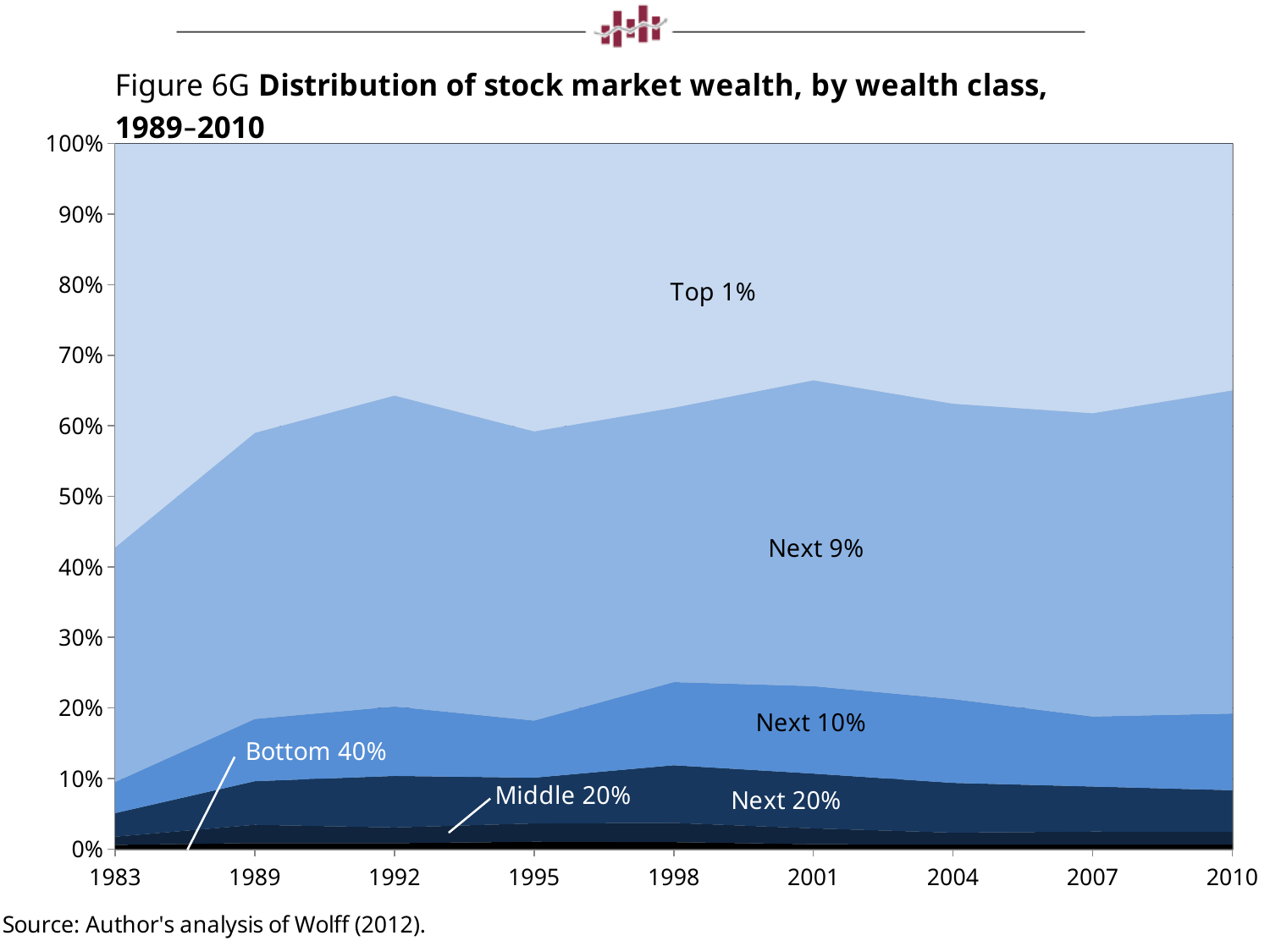
What source is cited below the chart? Author's analysis of Wolff (2012). What is the title of the chart? Figure 6G Distribution of stock market wealth, by wealth class, 1989–2010 Which wealth class occupies the topmost (lightest) band of the chart? Top 1% Is the share of stock market wealth held by the Next 9% in 2010 greater or less than 40%? greater How many years are marked along the x axis of the chart? 9 Is the Top 1% share of stock market wealth larger in 1983 or in 2010? 1983 Is the share of stock market wealth held by the Top 1% in 2001 greater or less than 40%? less Does the Top 1% share of stock market wealth rise or fall between 1983 and 1992? fall How many wealth classes are labelled in the chart? 6 Is the share of stock market wealth held by the Top 1% in 1983 greater or less than 50%? greater Which year shows the largest share of stock market wealth for the Top 1%? 1983 What kind of chart is shown on the slide? Stacked area chart